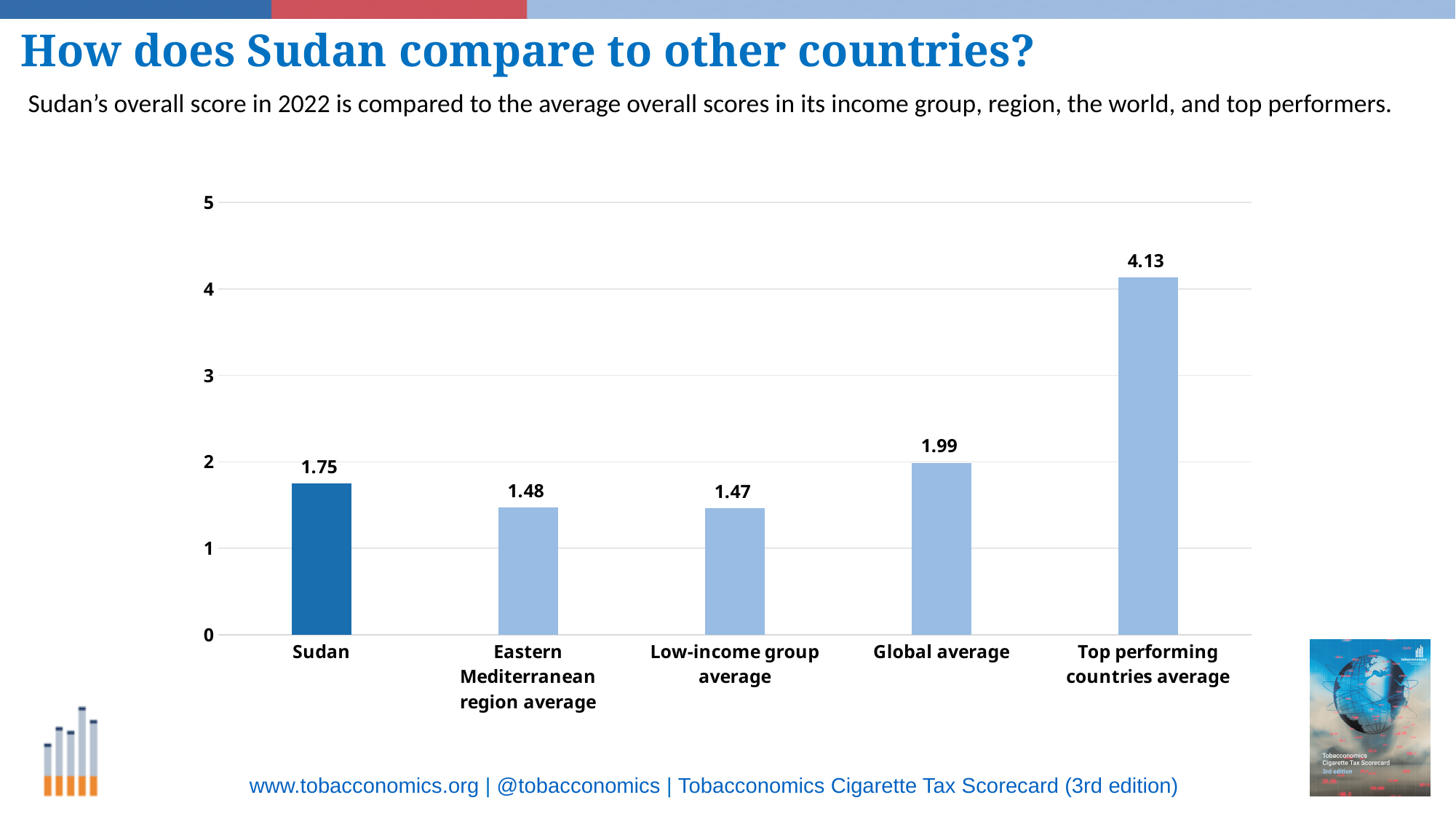
What is the value for the Global average? 1.99 What is the value for Sudan? 1.75 How many categories are shown in the chart? 5 What is the value for the Top performing countries average? 4.13 Is the value for the Top performing countries average greater or less than 4? greater What is the difference between the Global average and Sudan? 0.24 Which is larger, Sudan or the Global average? Global average What kind of chart is shown on the slide? Bar chart Which category has the highest value? Top performing countries average Which category has the lowest value? Low-income group average What is the difference between the Top performing countries average and Sudan? 2.38 Which bar is shown in a darker blue than the others? Sudan